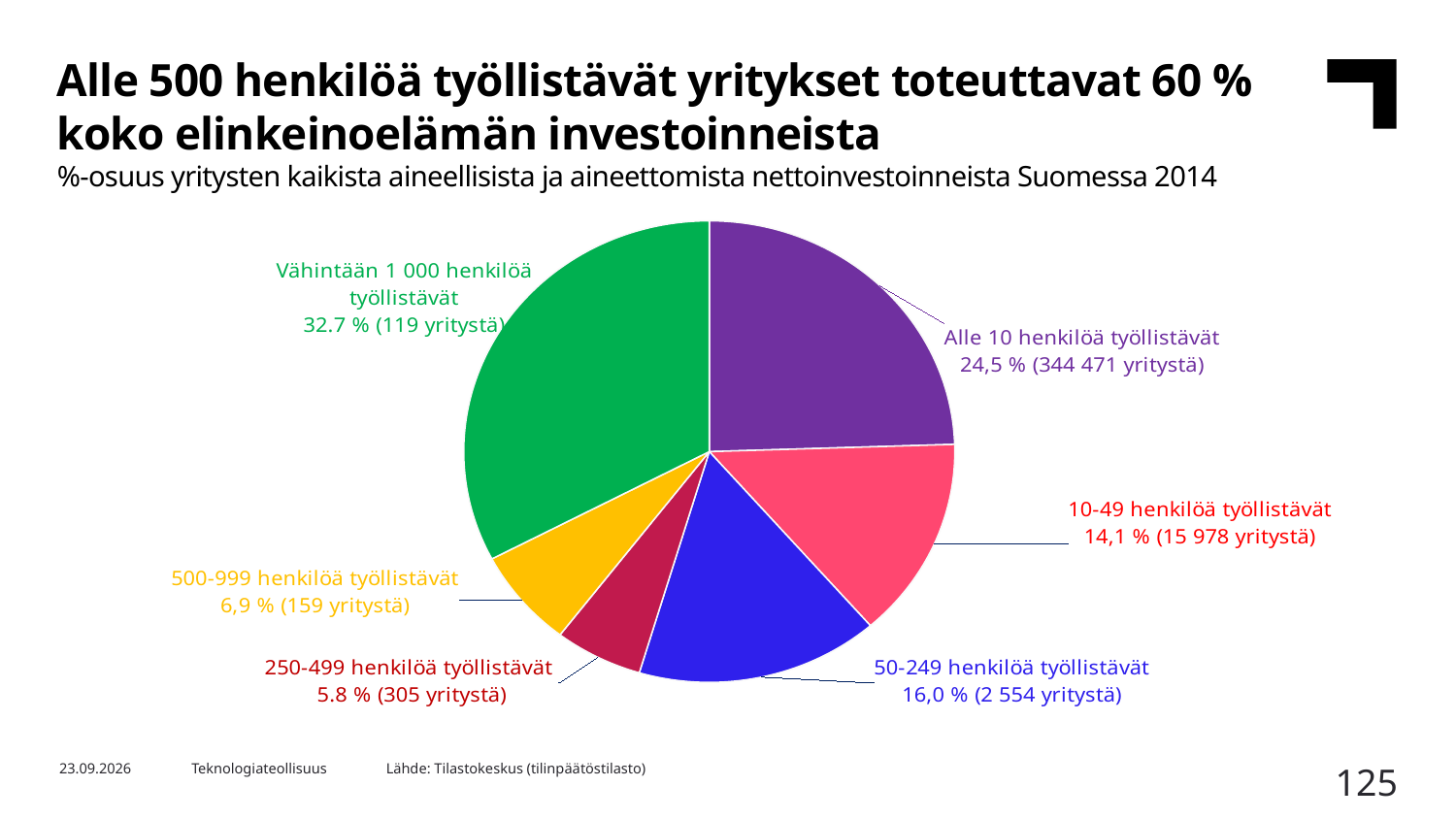
What colour is the slice for Alle 10 henkilöä työllistävät? purple What kind of chart is shown on the slide? pie chart Which category has the largest share of the pie? Vähintään 1 000 henkilöä työllistävät How many companies are in the 250-499 henkilöä työllistävät category? 305 How many companies are in the 10-49 henkilöä työllistävät category? 15 978 What share of net investments is attributed to companies employing fewer than 10 people (Alle 10 henkilöä työllistävät)? 24,5 % Which category has the smallest share of the pie? 250-499 henkilöä työllistävät How many slices does the pie chart have? 6 Which has a larger share: 500-999 henkilöä työllistävät or 250-499 henkilöä työllistävät? 500-999 henkilöä työllistävät What share of net investments is attributed to companies employing at least 1 000 people (Vähintään 1 000 henkilöä työllistävät)? 32.7 % What percentage is shown for companies employing 50-249 people? 16,0 % What is the difference in percentage points between the 50-249 and 10-49 employee categories? 1,9